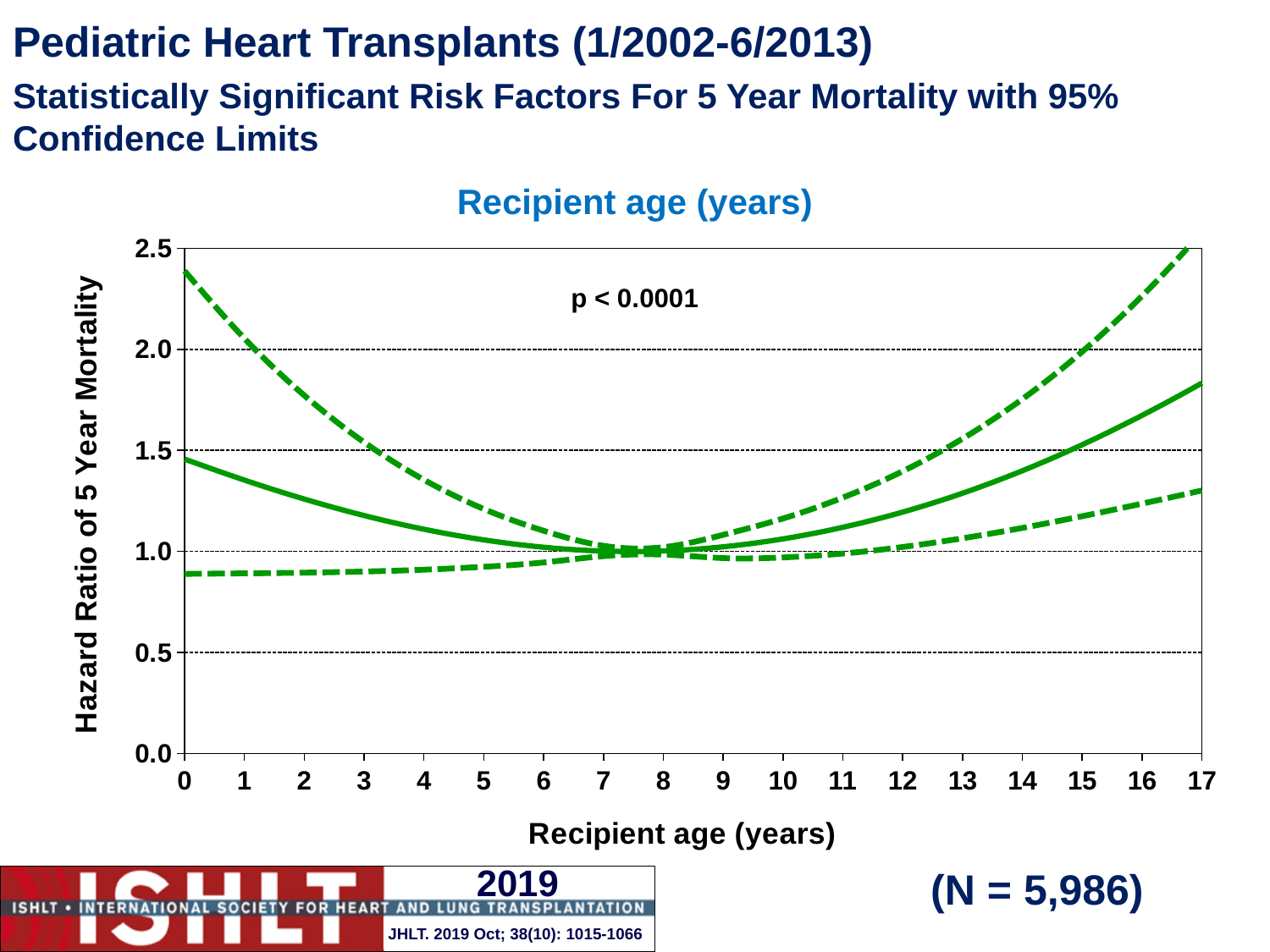
What is the title of the chart? Recipient age (years) Is the hazard ratio on the solid line at recipient age 12 greater or less than 1.5? less Is the lower dashed confidence limit at recipient age 0 greater or less than 1.0? less What p-value is printed on the chart? p < 0.0001 Is the hazard ratio on the solid line at recipient age 17 greater or less than 1.5? greater What kind of chart is shown on the slide? line chart Does the solid hazard ratio line rise or fall as recipient age increases from 8 to 17 years? rise Does the solid hazard ratio line rise or fall as recipient age increases from 0 to 7 years? fall How many lines are plotted on the chart? 3 On the solid line, is the hazard ratio larger at recipient age 0 or at recipient age 17? 17